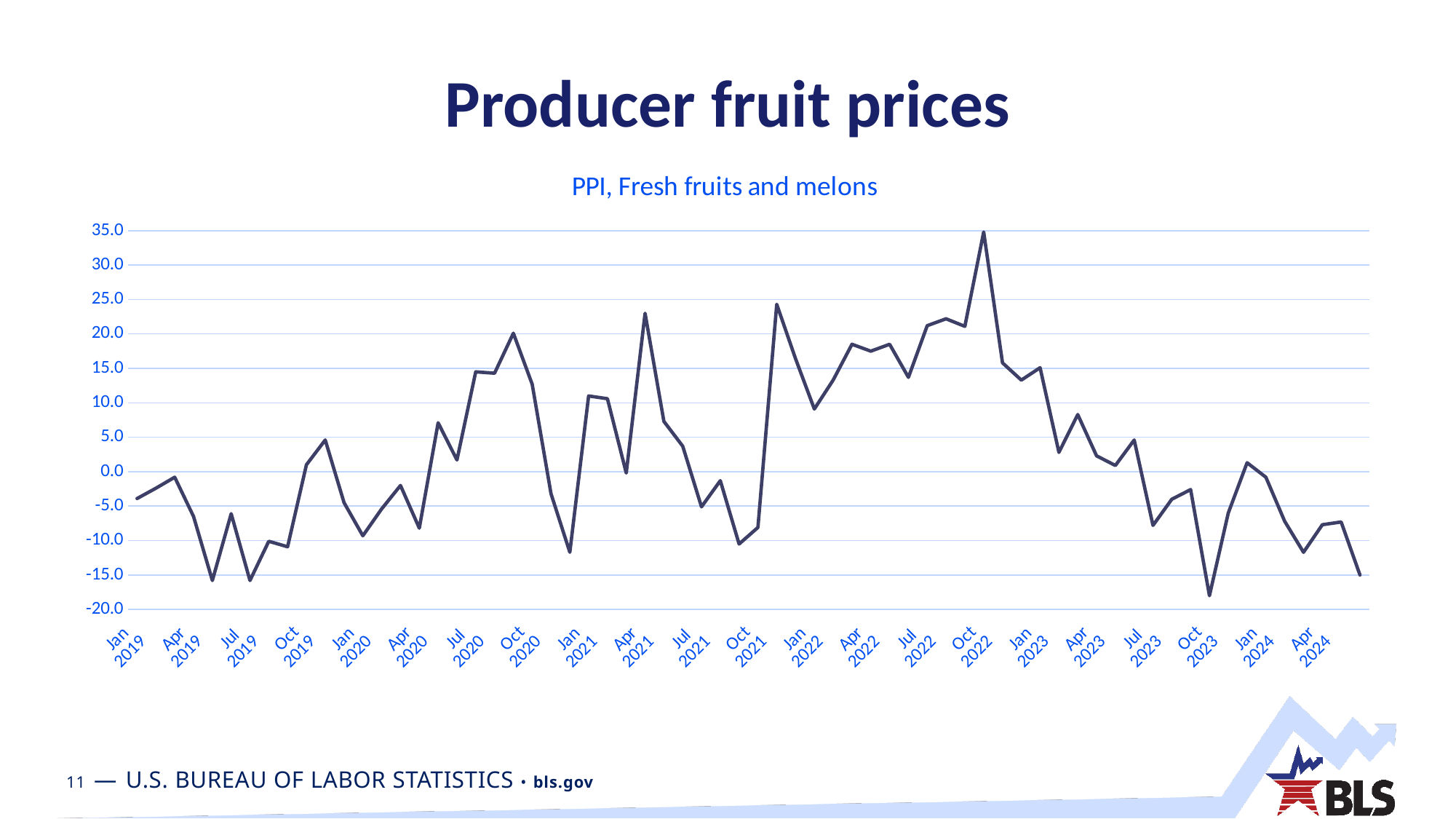
Is the value for Jan 2019 greater or less than 0.0? less Which is larger, the value for Jan 2022 or the value for Jan 2023? Jan 2023 Is the value for Jan 2022 greater or less than 20.0? less Which month on the x axis has the highest value? Oct 2022 What kind of chart is shown on the slide? line chart How many lines (data series) are plotted on the chart? 1 Is the value for Oct 2023 greater or less than -15.0? less What is the title of the chart? PPI, Fresh fruits and melons Do the values generally rise or fall between Oct 2022 and Oct 2023? fall